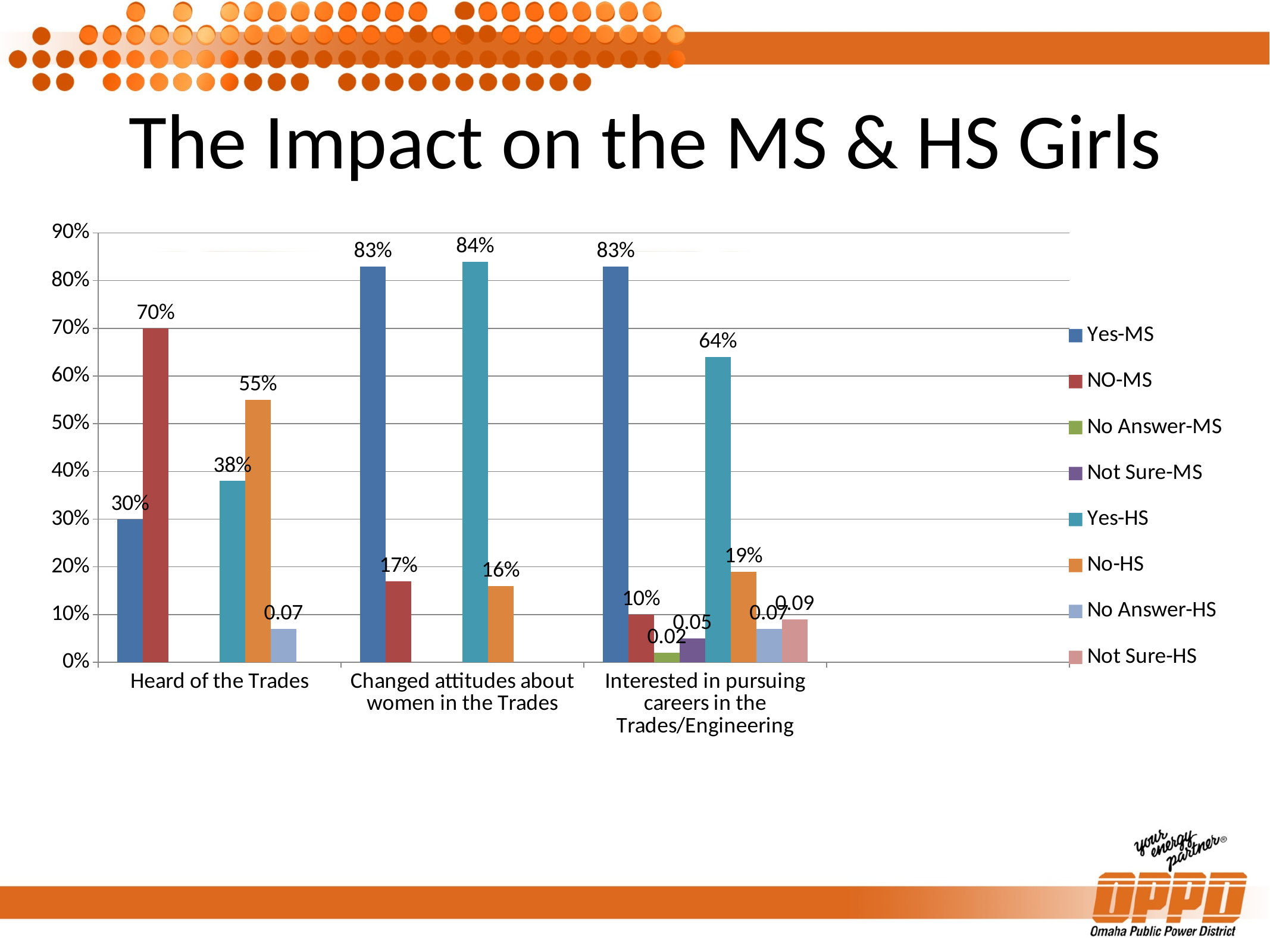
How many series does the legend list? 8 What is the value for Not Sure-HS in the 'Interested in pursuing careers in the Trades/Engineering' category? 0.09 Which series has the highest value in the 'Heard of the Trades' category? NO-MS Which series has the lowest value in the 'Interested in pursuing careers in the Trades/Engineering' category? No Answer-MS What is the title of the slide containing the chart? The Impact on the MS & HS Girls What is the value for Yes-HS in the 'Changed attitudes about women in the Trades' category? 84% What is the difference between Yes-MS and Yes-HS in the 'Interested in pursuing careers in the Trades/Engineering' category? 19% What kind of chart is shown on the slide? bar chart In the 'Heard of the Trades' category, which is larger: Yes-MS or Yes-HS? Yes-HS What is the value for NO-MS in the 'Heard of the Trades' category? 70% What is the value for No-HS in the 'Interested in pursuing careers in the Trades/Engineering' category? 19% How many categories are shown on the x axis? 3